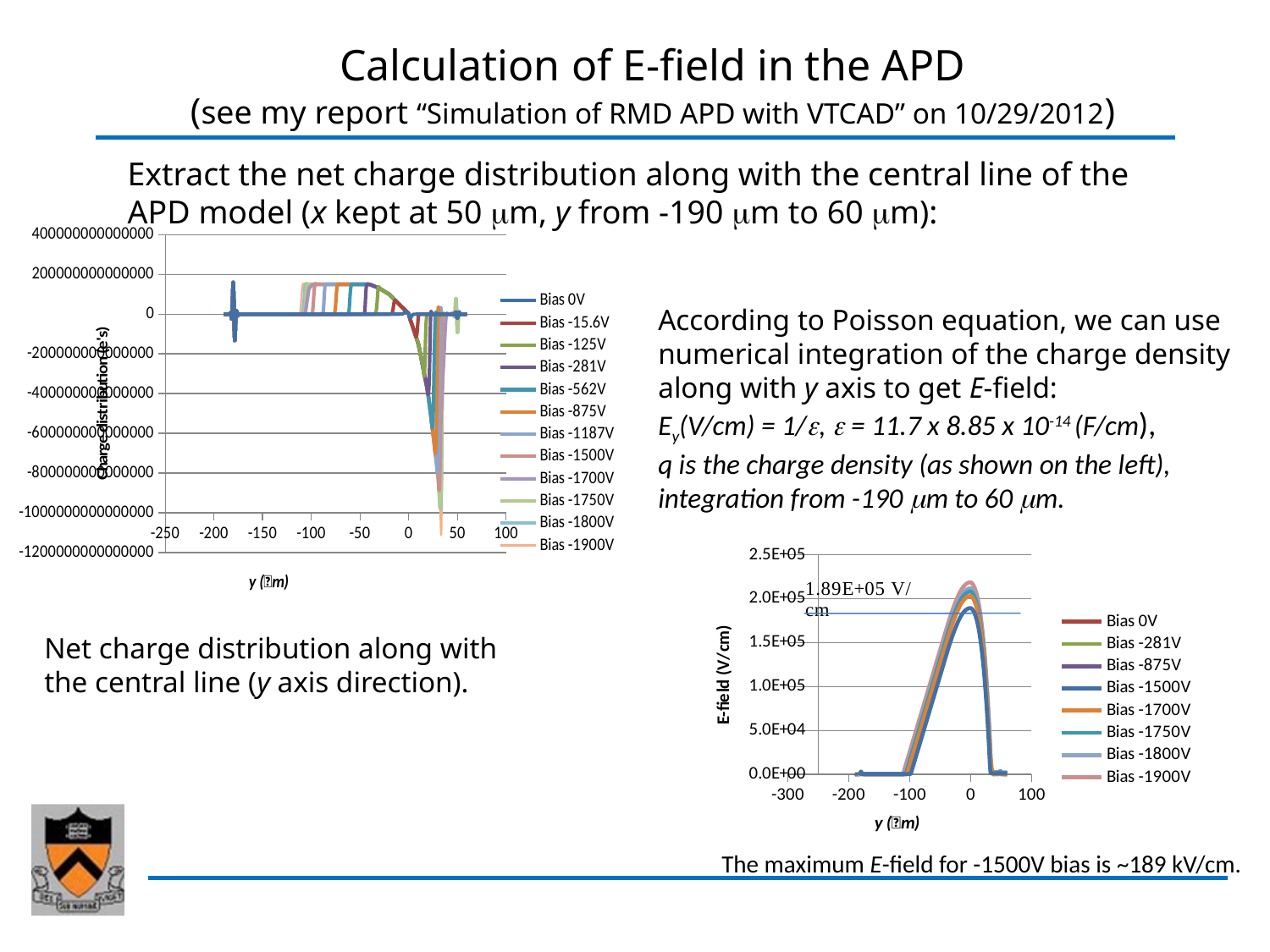
In the left (charge distribution) chart, is the lowest value reached by the curves greater or less than -600000000000000? less What kind of chart is the left chart showing the net charge distribution? line chart In the right (E-field) chart, does the E-field rise or fall as y goes from -100 to 0? rise Which series is listed last in the legend of the right (E-field) chart? Bias -1900V In the right (E-field) chart, which series has the higher peak E-field, Bias -1900V or Bias -1500V? Bias -1900V In the right (E-field) chart, is the E-field at y = -200 greater or less than 5.0E+04? less What kind of chart is the right chart showing the E-field? line chart What is the y-axis label of the right (E-field) chart? E-field (V/cm) How many series does the legend of the right (E-field) chart list? 8 In the right (E-field) chart, is the peak E-field for Bias -1500V greater or less than 2.0E+05? less In the right (E-field) chart, what maximum E-field value is annotated for the -1500V bias? 1.89E+05 V/cm How many series does the legend of the left (charge distribution) chart list? 12